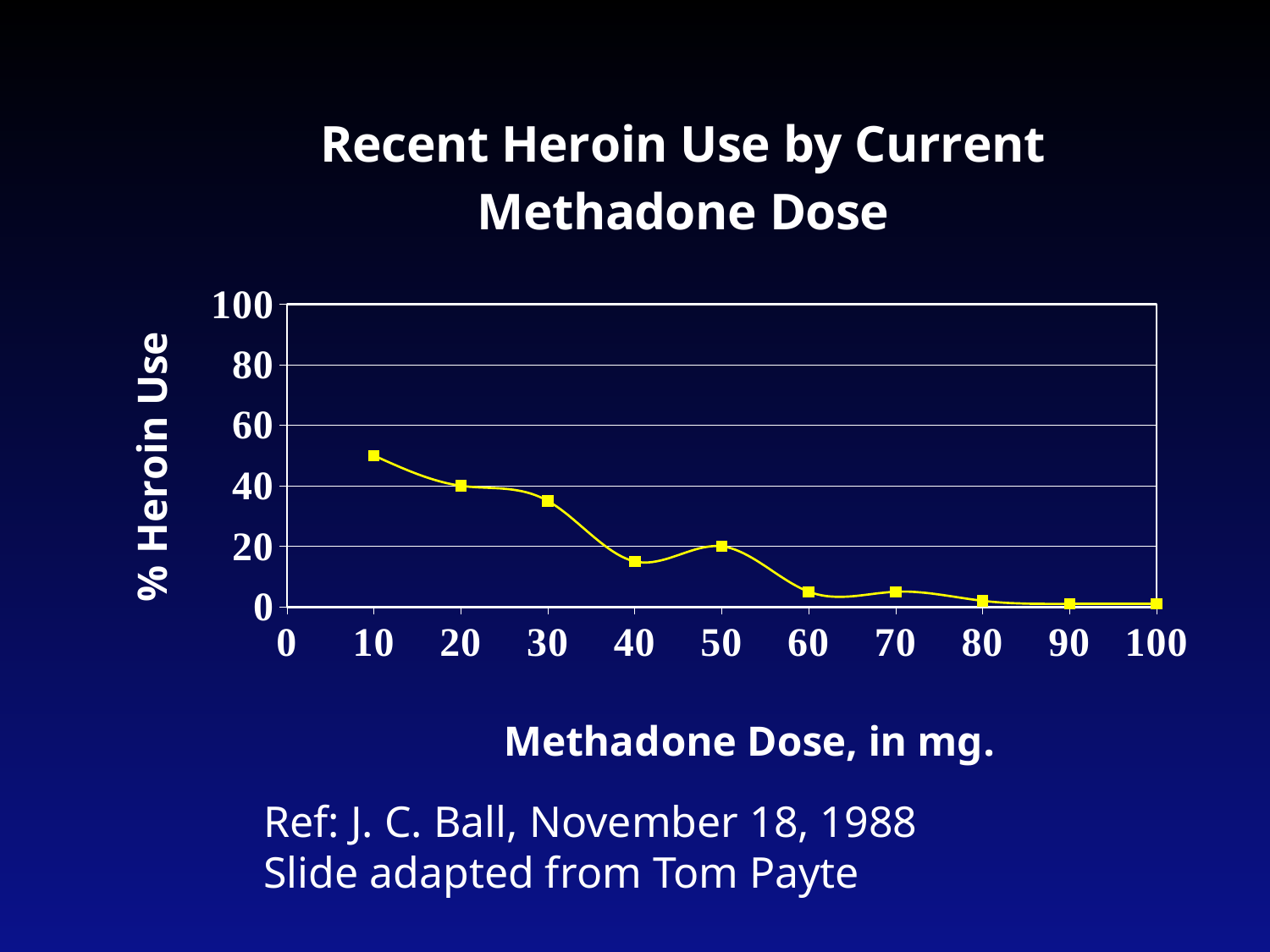
Is the % heroin use at a methadone dose of 10 mg greater or less than 40? greater Which has a higher % heroin use: a methadone dose of 30 mg or 50 mg? 30 mg What is the label of the y axis? % Heroin Use Is the % heroin use at a methadone dose of 30 mg greater or less than 40? less Is the % heroin use at a methadone dose of 40 mg greater or less than 20? less What is the title of the chart? Recent Heroin Use by Current Methadone Dose Which has a higher % heroin use: a methadone dose of 10 mg or 40 mg? 10 mg Do the values rise or fall as the methadone dose increases along the x axis? fall What kind of chart is shown on the slide? line chart How many data points are plotted on the line? 10 At which methadone dose is the % heroin use highest? 10